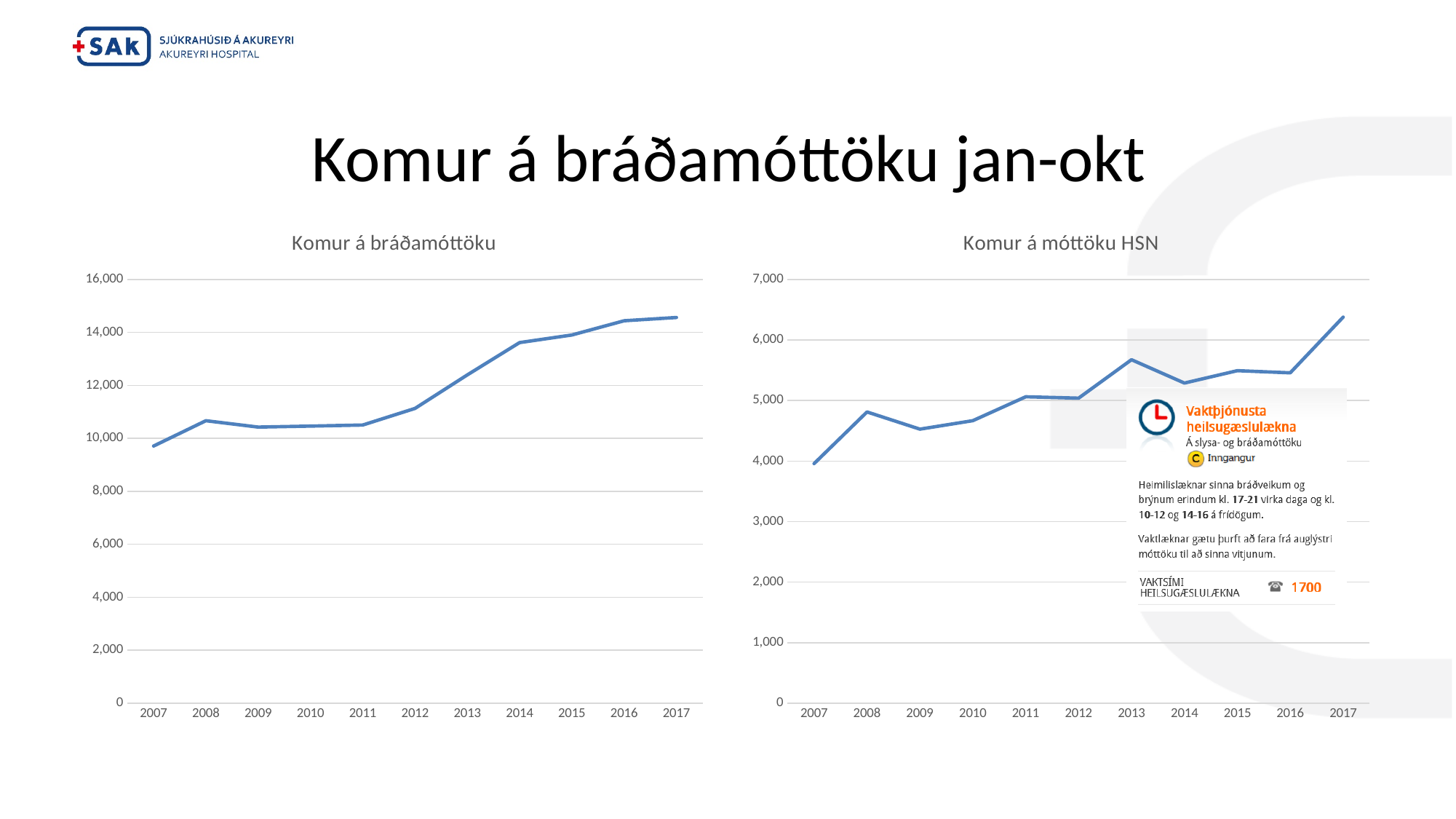
In the left chart "Komur á bráðamóttöku", is the value for 2007 greater or less than 10,000? less In the left chart "Komur á bráðamóttöku", is the value for 2014 larger than the value for 2012? yes In the left chart "Komur á bráðamóttöku", which year has the highest value? 2017 In the right chart "Komur á móttöku HSN", which year has the lowest value? 2007 In the left chart "Komur á bráðamóttöku", which year has the lowest value? 2007 How many years are plotted on the x axis of the left chart "Komur á bráðamóttöku"? 11 In the right chart "Komur á móttöku HSN", is the value for 2013 larger or smaller than the value for 2014? larger What kind of chart is the left chart titled "Komur á bráðamóttöku"? line chart In the right chart "Komur á móttöku HSN", which year has the highest value? 2017 What is the title of the right chart? Komur á móttöku HSN In the left chart "Komur á bráðamóttöku", is the value for 2016 greater or less than 14,000? greater In the right chart "Komur á móttöku HSN", is the value for 2017 greater or less than 6,000? greater